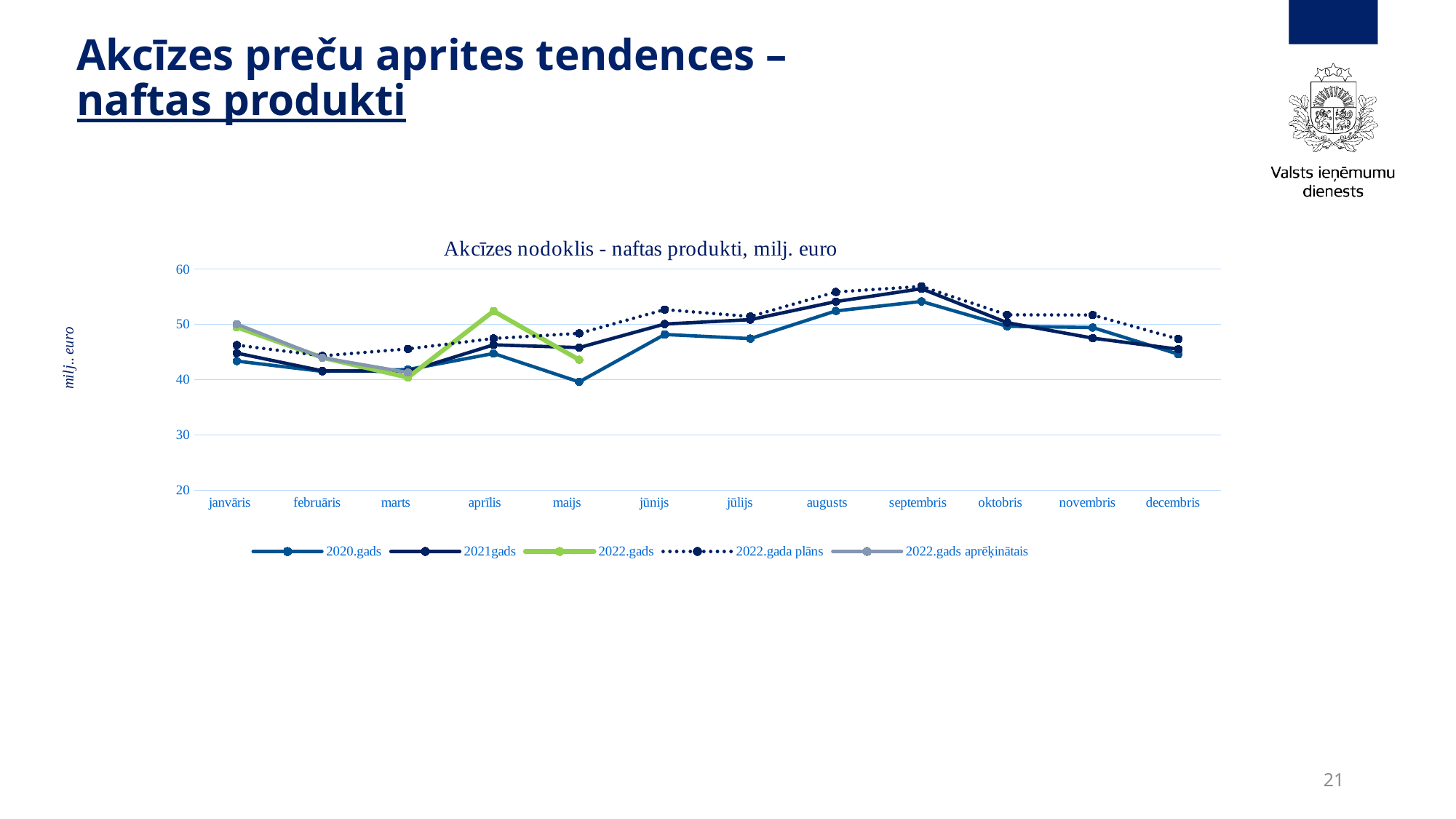
In which month does the 2022.gads series reach its lowest value? marts How many series does the chart legend list? 5 Does the 2020.gads series rise or fall from septembris to decembris? fall In which month does the 2022.gads series reach its highest value? aprīlis How many months are shown along the x axis of the chart? 12 Is the value for 2022.gads in aprīlis greater or less than 50? greater What kind of chart is shown on the slide? line chart Is the value for 2021gads in marts greater or less than 50? less Which series in the legend is drawn with a dotted line? 2022.gada plāns What is the title of the chart? Akcīzes nodoklis - naftas produkti, milj. euro In aprīlis, which series has the larger value: 2022.gads or 2021gads? 2022.gads Is the value for 2022.gada plāns in augusts greater or less than 50? greater